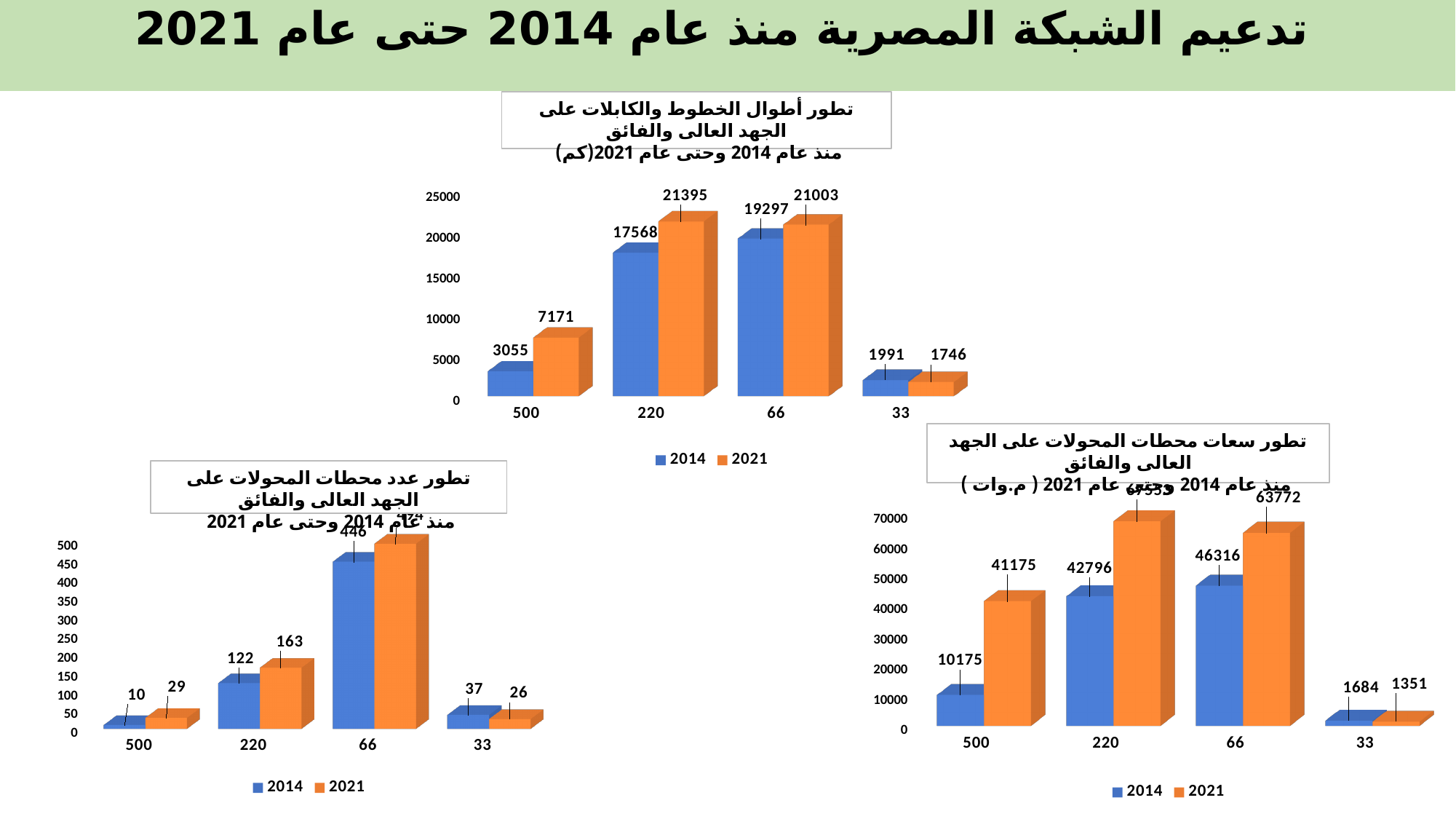
In the top chart, which is larger for category 33: the 2014 value or the 2021 value? 2014 In the bottom-left chart, what is the 2014 value for category 66? 446 In the top chart, what is the 2014 value for category 500? 3055 How many series does the legend of the bottom-right chart list? 2 In the top chart, what is the difference between the 2021 and 2014 values for category 500? 4116 In the bottom-right chart, what is the 2021 value for category 66? 63772 In the bottom-left chart, what is the 2021 value for category 220? 163 In the bottom-left chart, which category has the lowest 2014 value? 500 What kind of chart is the top chart? Bar chart In the bottom-right chart, what is the difference between the 2021 and 2014 values for category 500? 31000 In the top chart, what is the 2021 value for category 220? 21395 In the top chart, which category has the highest 2014 value? 66